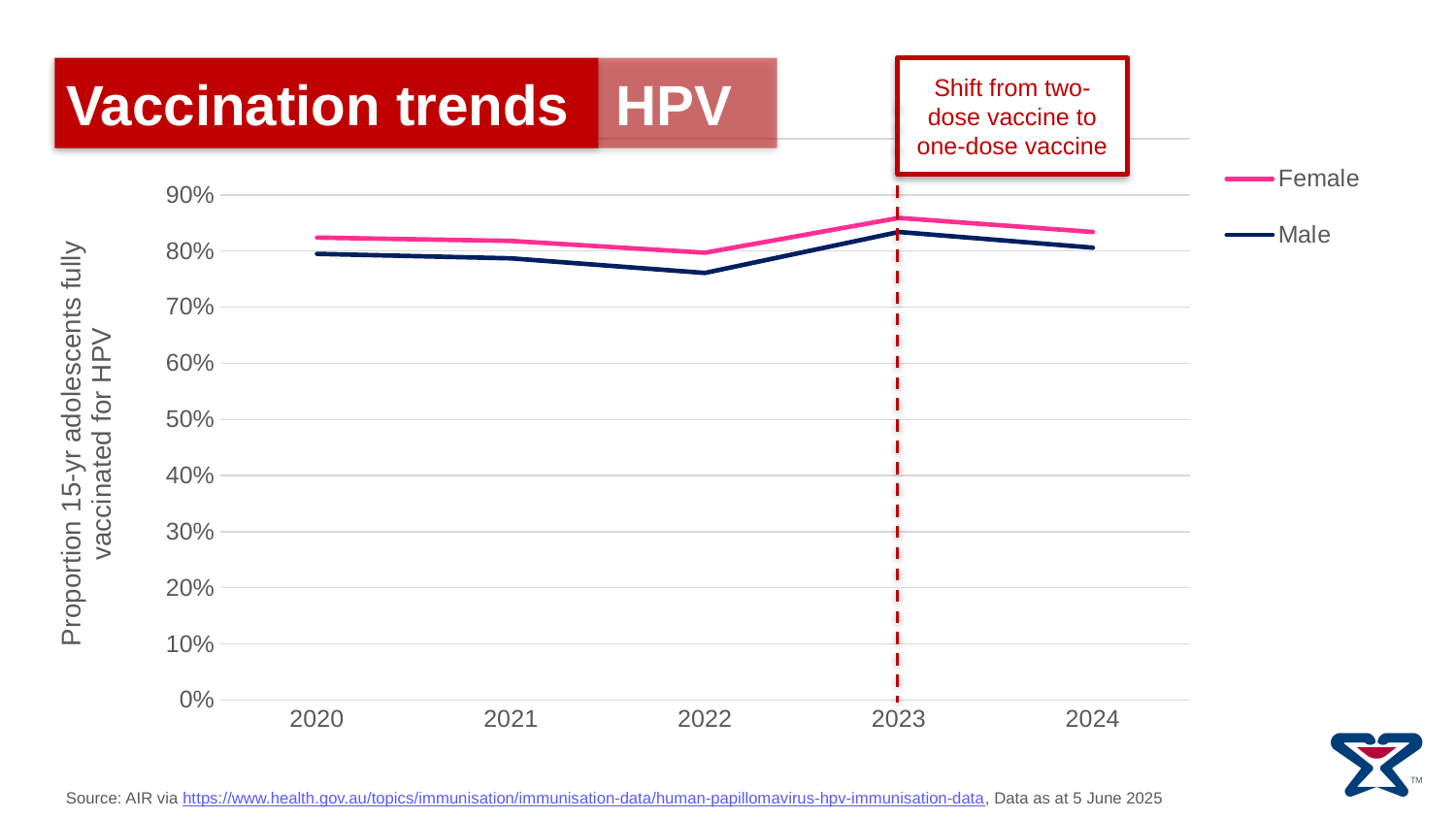
In which year is the Male series at its lowest? 2022 What kind of chart is shown on the slide? line chart In which year is the Female series at its lowest? 2022 What does the annotation at the dashed line in 2023 say? Shift from two-dose vaccine to one-dose vaccine Do the Female and Male values rise or fall from 2022 to 2023? rise Is the value for Female in 2023 greater or less than 80%? greater How many series does the legend list? 2 Is the value for Male in 2022 greater or less than 80%? less In which year is the Male series at its highest? 2023 In which year is the Female series at its highest? 2023 How many years are plotted along the x axis? 5 In 2022, which series has the higher value, Female or Male? Female